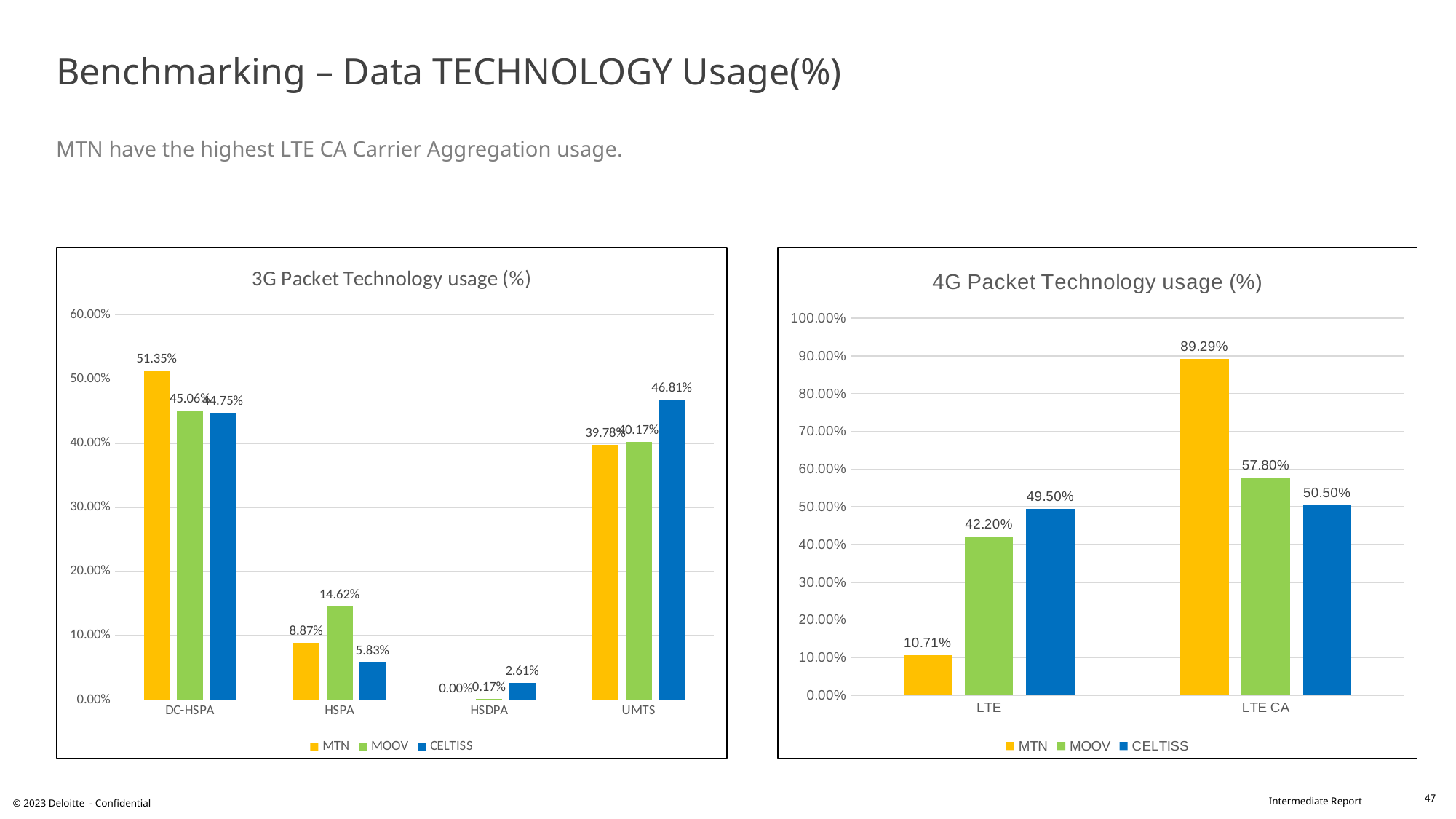
In the 4G Packet Technology usage (%) chart, what is the difference between MTN's LTE CA value and MOOV's LTE CA value? 31.49% How many categories are shown on the x axis of the 3G Packet Technology usage (%) chart? 4 In the 3G Packet Technology usage (%) chart, which is larger in the UMTS category: the MTN value or the CELTISS value? CELTISS In the 3G Packet Technology usage (%) chart, what is the value for MTN in the DC-HSPA category? 51.35% How many series does the legend of the 4G Packet Technology usage (%) chart list? 3 In the 3G Packet Technology usage (%) chart, what is the difference between MOOV's HSPA value and CELTISS's HSPA value? 8.79% In the 4G Packet Technology usage (%) chart, which operator has the highest value in the LTE CA category? MTN In the 4G Packet Technology usage (%) chart, what is the value for CELTISS in the LTE category? 49.50% In the 3G Packet Technology usage (%) chart, what is the value for MOOV in the HSPA category? 14.62% In the 4G Packet Technology usage (%) chart, which operator has the lowest value in the LTE category? MTN What type of chart is the 4G Packet Technology usage (%) chart? Bar chart In the 4G Packet Technology usage (%) chart, what is the value for MTN in the LTE CA category? 89.29%